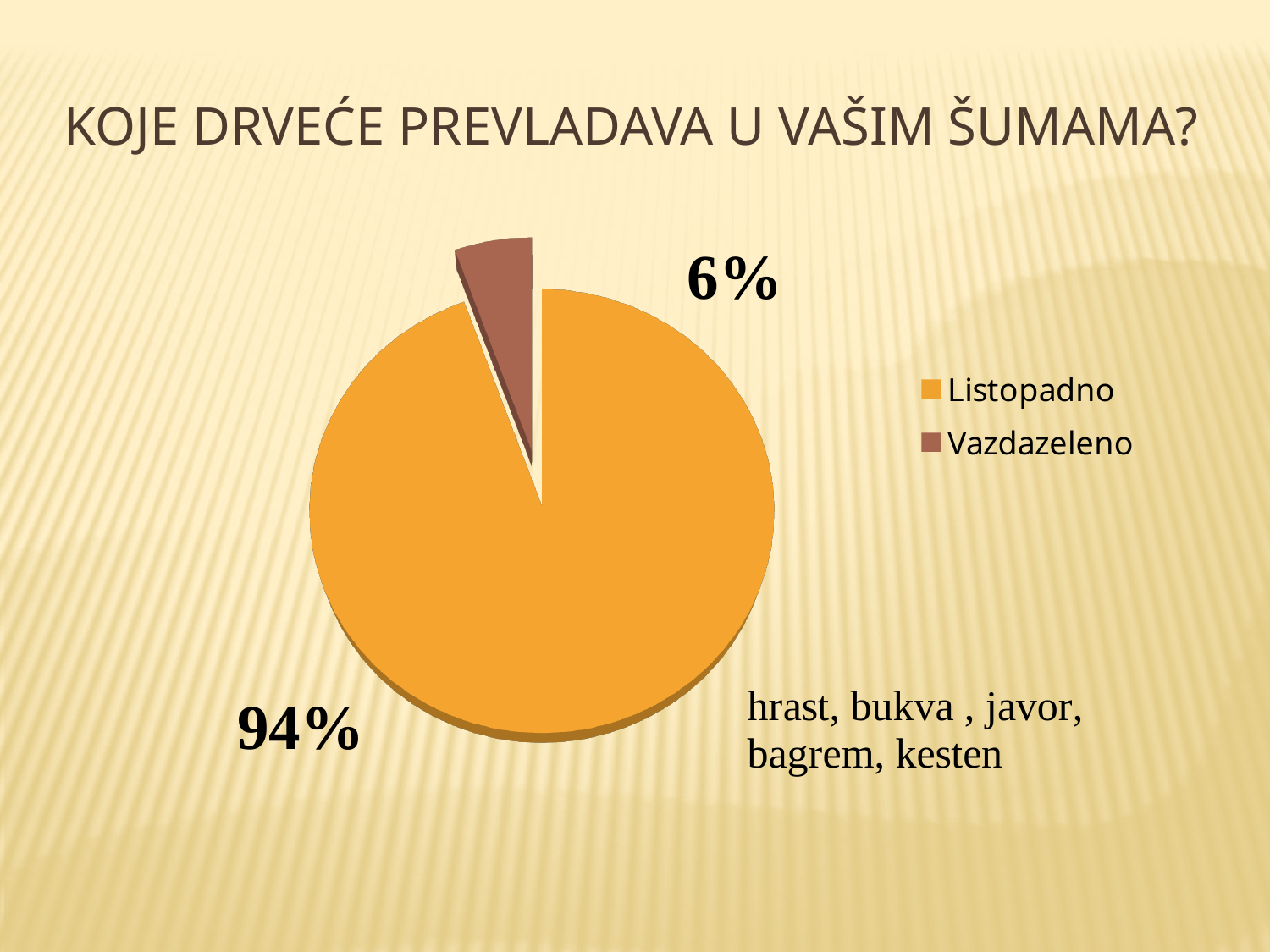
What colour is the Vazdazeleno slice? Brown What is the title of the slide? KOJE DRVEĆE PREVLADAVA U VAŠIM ŠUMAMA? Which category has the smallest slice of the pie? Vazdazeleno What share of the pie does Listopadno represent? 94% What share of the pie does Vazdazeleno represent? 6% What is the total of the two percentages shown on the pie chart? 100% What kind of chart is shown on the slide? Pie chart Which is larger, Listopadno or Vazdazeleno? Listopadno How many entries does the legend list? 2 Which category has the largest slice of the pie? Listopadno How many slices does the pie chart have? 2 What is the difference in percentage points between Listopadno and Vazdazeleno? 88